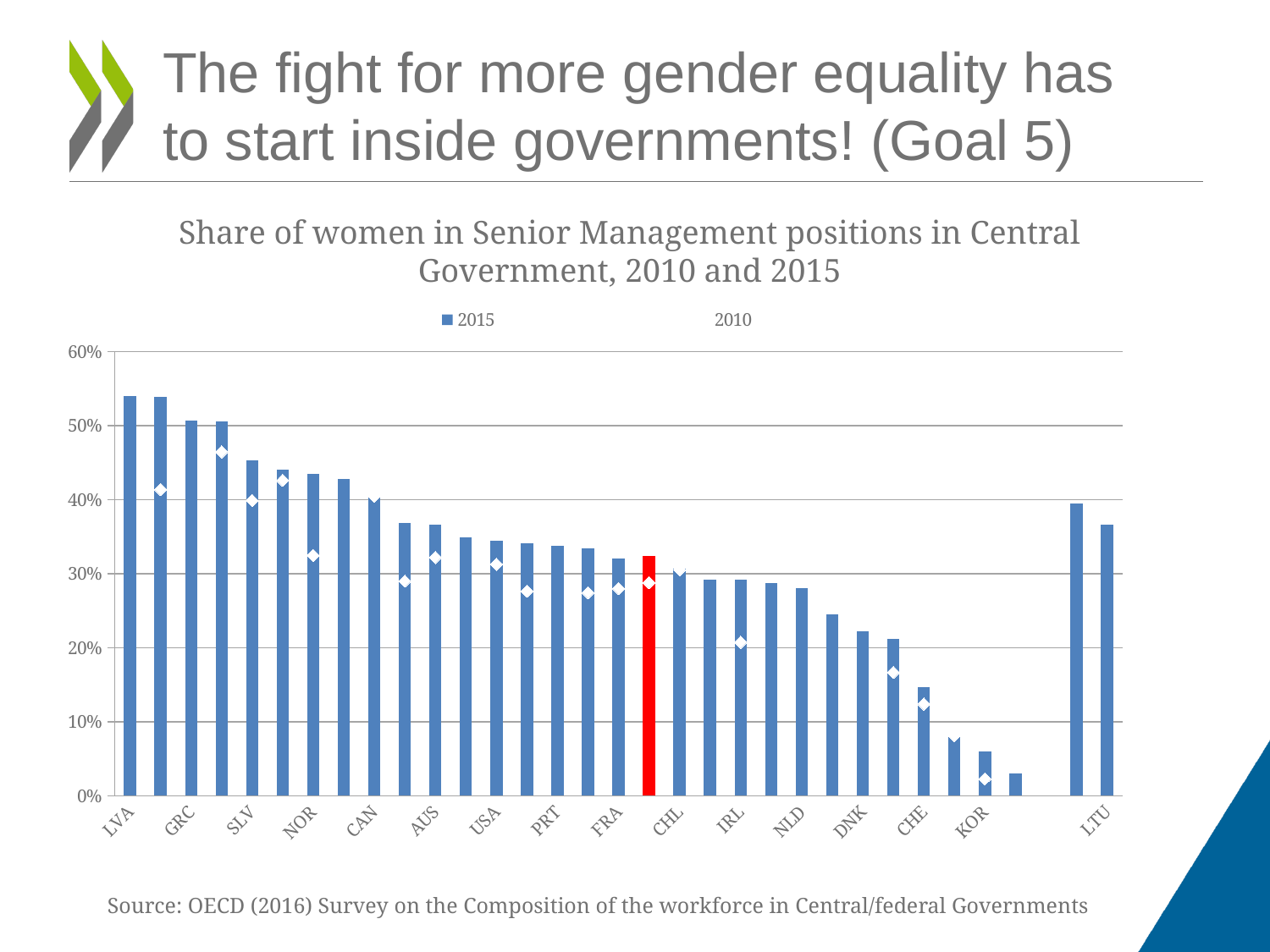
Do the 2015 bars generally rise or fall moving from LVA to KOR along the x axis? fall Is the 2015 value for KOR greater or less than 10%? less Is the 2015 value for SLV greater or less than 40%? greater Is the 2015 value for CHE greater or less than 20%? less What is the title of the chart? Share of women in Senior Management positions in Central Government, 2010 and 2015 What kind of chart is shown on the slide? bar chart Which two years are listed in the chart legend? 2015 and 2010 Which has the larger 2015 value, LVA or KOR? LVA How many series does the legend list? 2